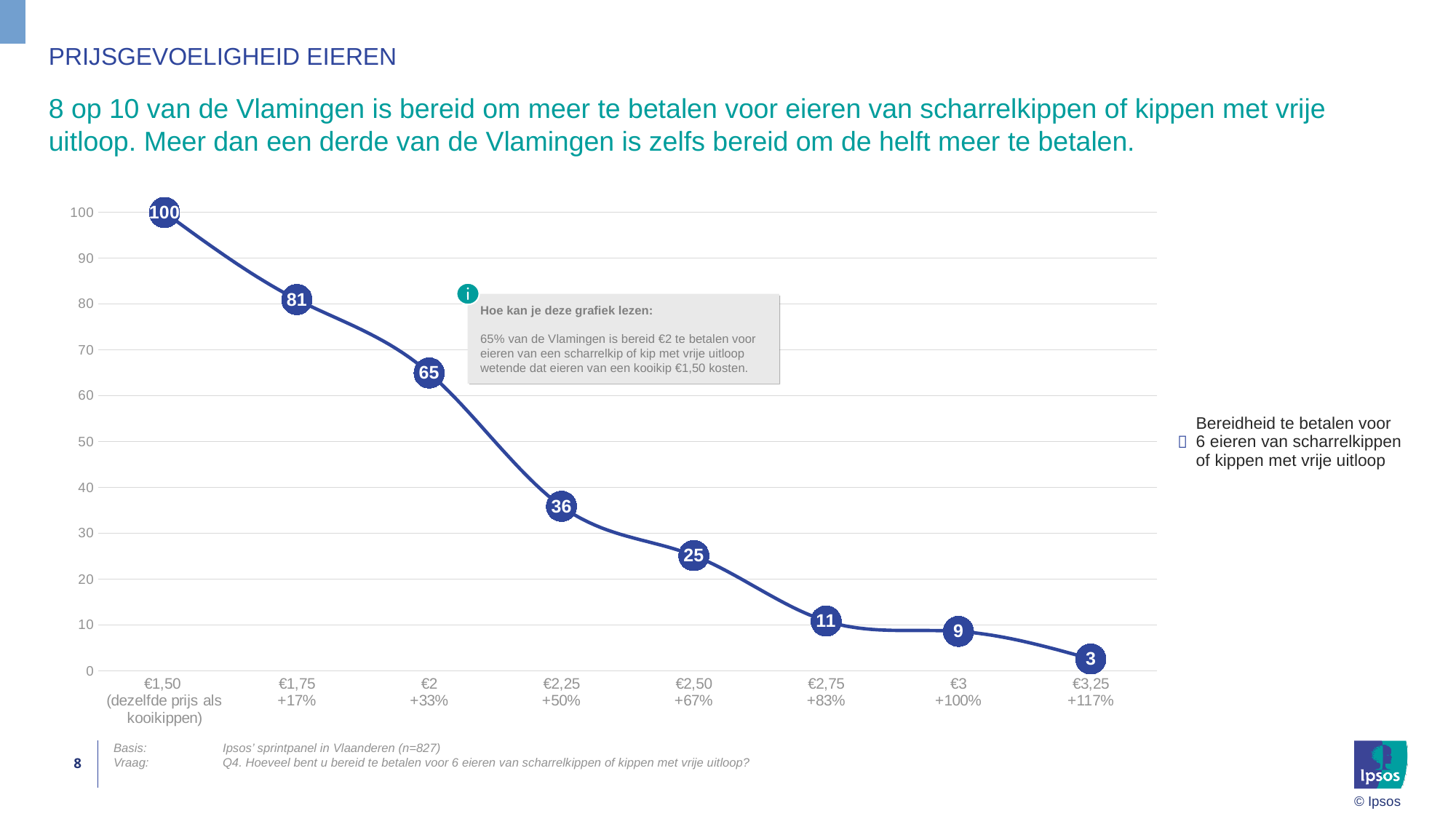
What is the difference between the values at €2,25 and €2,50? 11 How many price points are plotted on the chart? 8 What is the value at €2,75? 11 Do the values rise or fall as the price increases along the x axis? Fall What kind of chart is shown on the slide? Line chart Which price point has the highest value? €1,50 What is the value at €3,25? 3 Which price point has the lowest value? €3,25 What is the difference between the values at €1,75 and €2? 16 What is the value at the €2 price point? 65 What is the legend entry for the plotted line? Bereidheid te betalen voor 6 eieren van scharrelkippen of kippen met vrije uitloop Which is larger, the value at €2,50 or the value at €3? €2,50